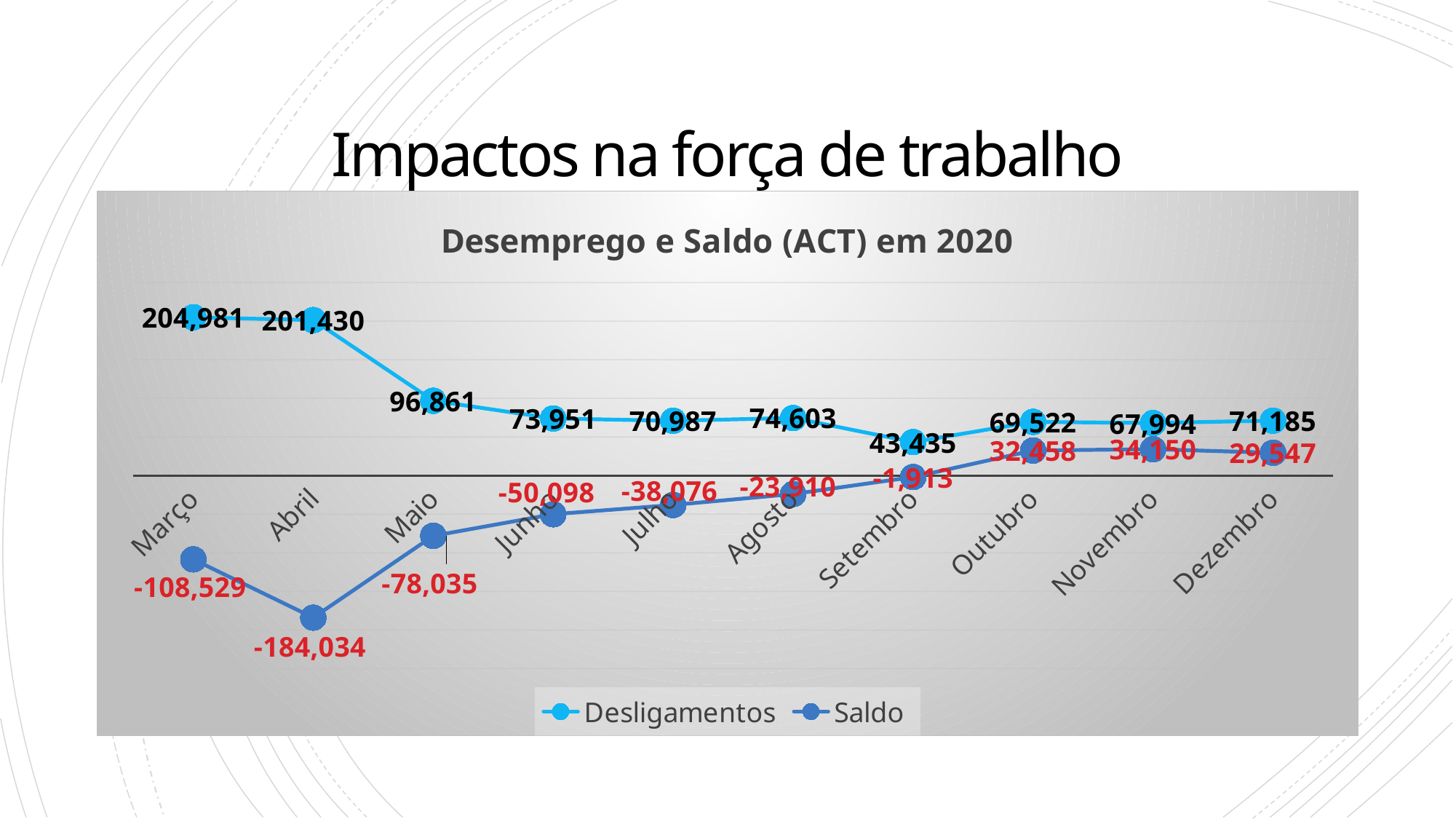
Which is larger, the Desligamentos value for Maio or for Junho? Maio What is the value of Saldo for Dezembro? 29,547 How many months are plotted on the x axis? 10 What is the value of Saldo for Abril? -184,034 What is the difference between the Desligamentos values for Março and Abril? 3,551 What is the value of Desligamentos for Setembro? 43,435 Which month has the lowest value of Saldo? Abril What is the value of Desligamentos for Março? 204,981 Which month has the highest value of Desligamentos? Março How many series does the legend list? 2 What kind of chart is shown? Line chart What is the difference between the Saldo values for Novembro and Outubro? 1,692